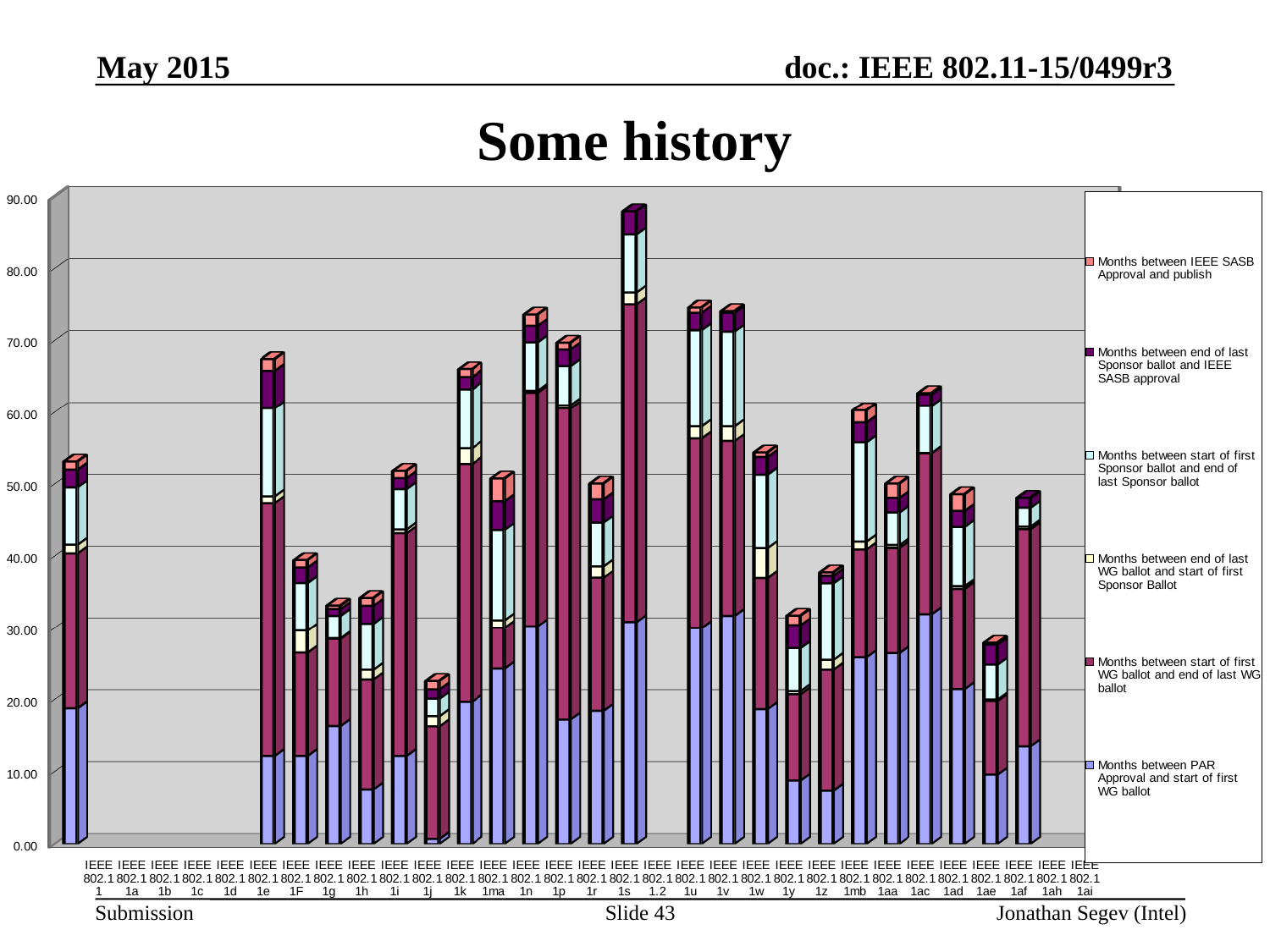
Is the total for IEEE 802.11ae greater or less than 30? less What is the title of the slide containing the chart? Some history How many series does the legend list? 6 Is the total for IEEE 802.11e greater or less than 60? greater Is the total for IEEE 802.11j greater or less than 30? less Which series is listed at the bottom of the legend? Months between PAR Approval and start of first WG ballot What kind of chart is shown on the slide? stacked bar chart Which category has the tallest stacked bar? IEEE 802.11s Which has the taller stacked bar, IEEE 802.11s or IEEE 802.11n? IEEE 802.11s How many categories are labelled along the x axis? 31 Which has the taller stacked bar, IEEE 802.11e or IEEE 802.11F? IEEE 802.11e